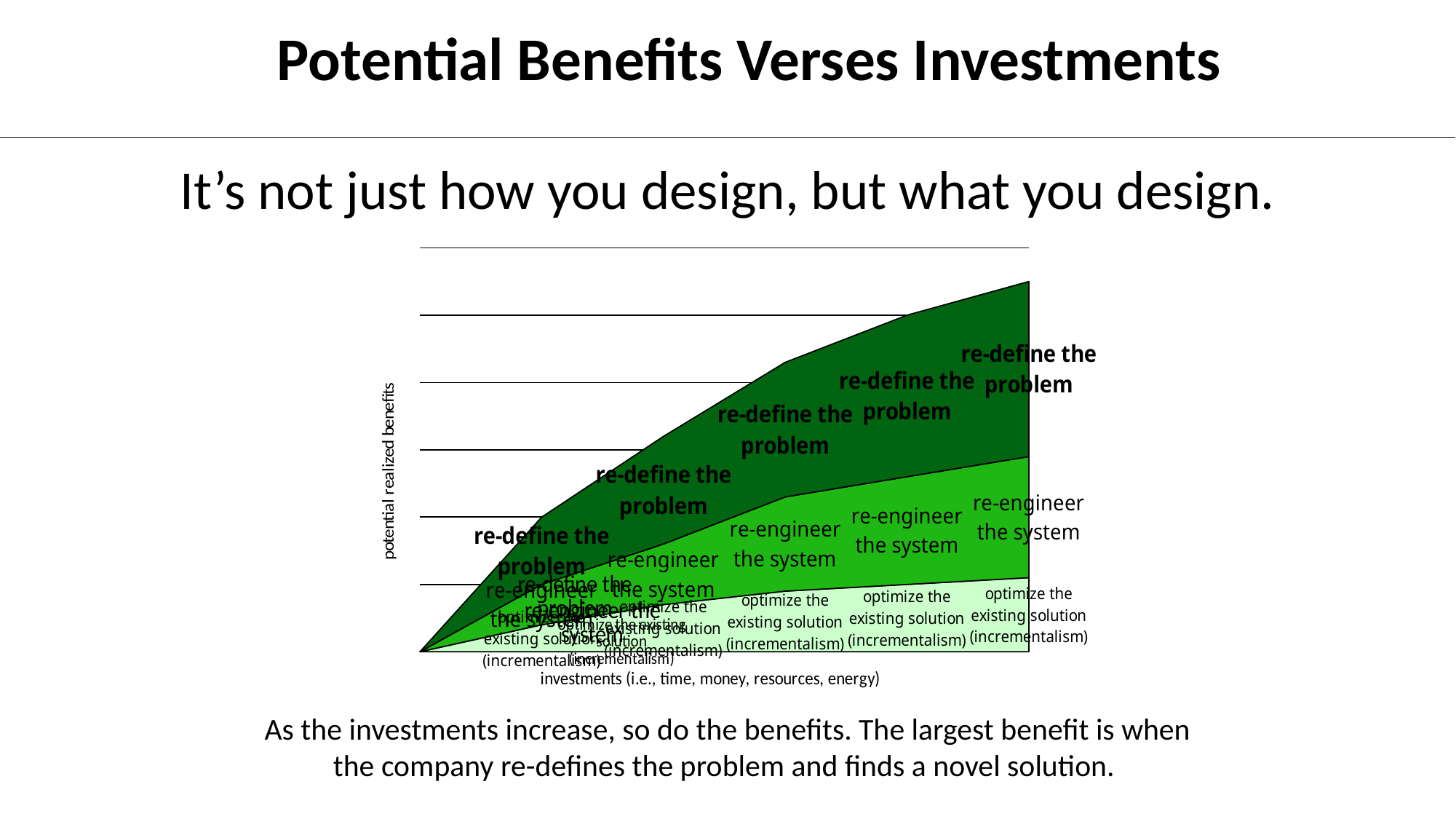
Which layer is the thinnest at the right-hand end of the chart? optimize the existing solution (incrementalism) How many layers (series) are stacked in the chart? 3 Which layer is at the top of the stacked chart? re-define the problem What is the label of the horizontal axis of the chart? investments (i.e., time, money, resources, energy) Which layer is at the bottom of the stacked chart? optimize the existing solution (incrementalism) What kind of chart is shown on the slide? stacked area chart What is the label of the vertical axis of the chart? potential realized benefits Which layer sits between 'optimize the existing solution' and 're-define the problem'? re-engineer the system Do the potential realized benefits rise or fall as investments increase along the x axis? rise Which layer is the thickest at the right-hand end of the chart? re-define the problem